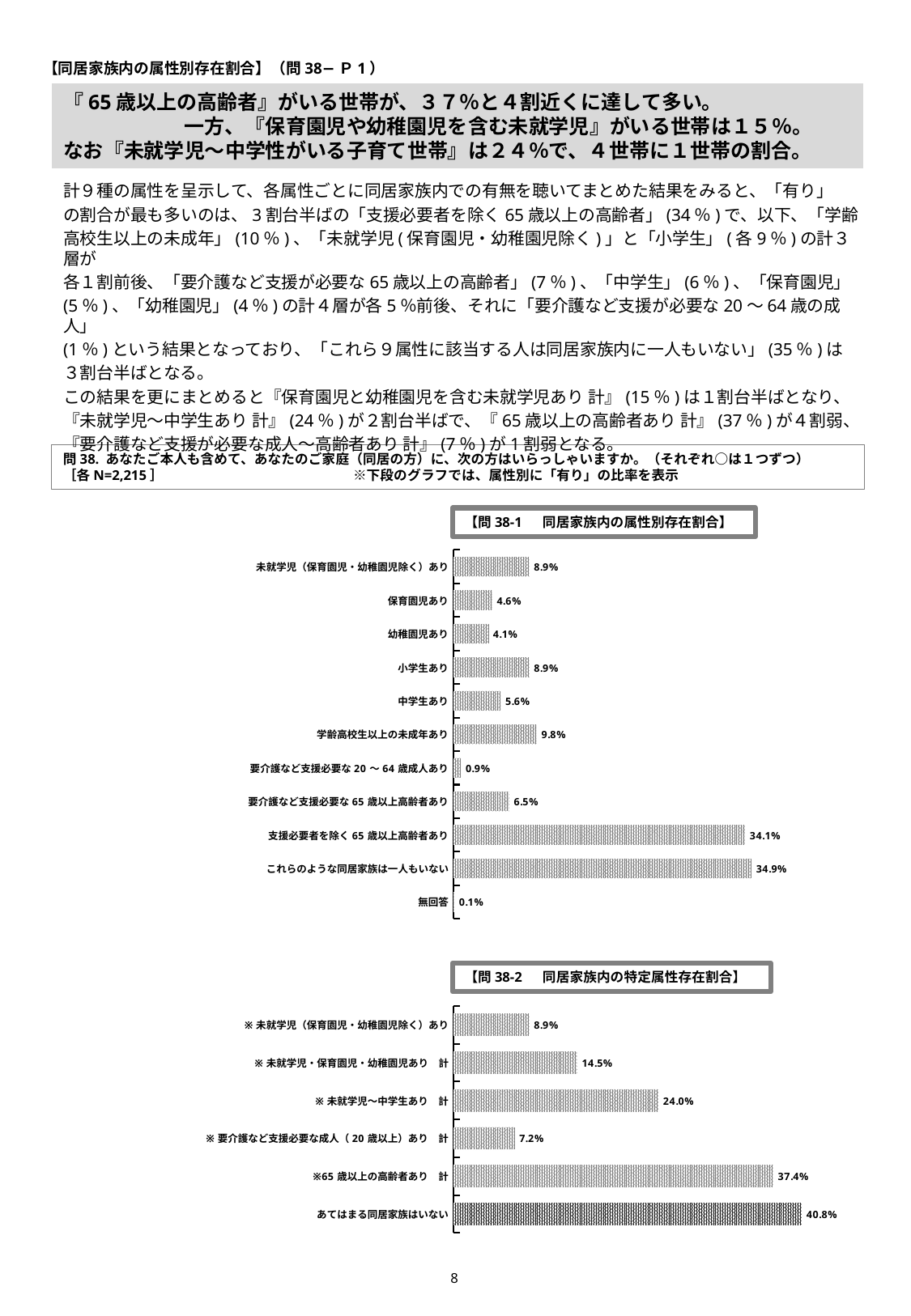
In the 【問38-2 同居家族内の特定属性存在割合】 chart, which category has the highest value? あてはまる同居家族はいない In the 【問38-2 同居家族内の特定属性存在割合】 chart, what is the difference between ※65歳以上の高齢者あり 計 and ※未就学児・保育園児・幼稚園児あり 計? 22.9% In the 【問38-1 同居家族内の属性別存在割合】 chart, what is the difference between 保育園児あり and 幼稚園児あり? 0.5% How many categories are shown in the 【問38-2 同居家族内の特定属性存在割合】 chart? 6 In the 【問38-1 同居家族内の属性別存在割合】 chart, which category has the lowest value? 無回答 In the 【問38-2 同居家族内の特定属性存在割合】 chart, which category has the lowest value? ※要介護など支援必要な成人（20歳以上）あり 計 In the 【問38-1 同居家族内の属性別存在割合】 chart, which is larger: 中学生あり or 要介護など支援必要な65歳以上高齢者あり? 要介護など支援必要な65歳以上高齢者あり How many categories are shown in the 【問38-1 同居家族内の属性別存在割合】 chart? 11 What kind of chart is the 【問38-1 同居家族内の属性別存在割合】 chart? Bar chart In the 【問38-2 同居家族内の特定属性存在割合】 chart, what is the value for ※未就学児〜中学生あり 計? 24.0% In the 【問38-1 同居家族内の属性別存在割合】 chart, what is the value for 支援必要者を除く65歳以上高齢者あり? 34.1% In the 【問38-1 同居家族内の属性別存在割合】 chart, which category has the highest value? これらのような同居家族は一人もいない